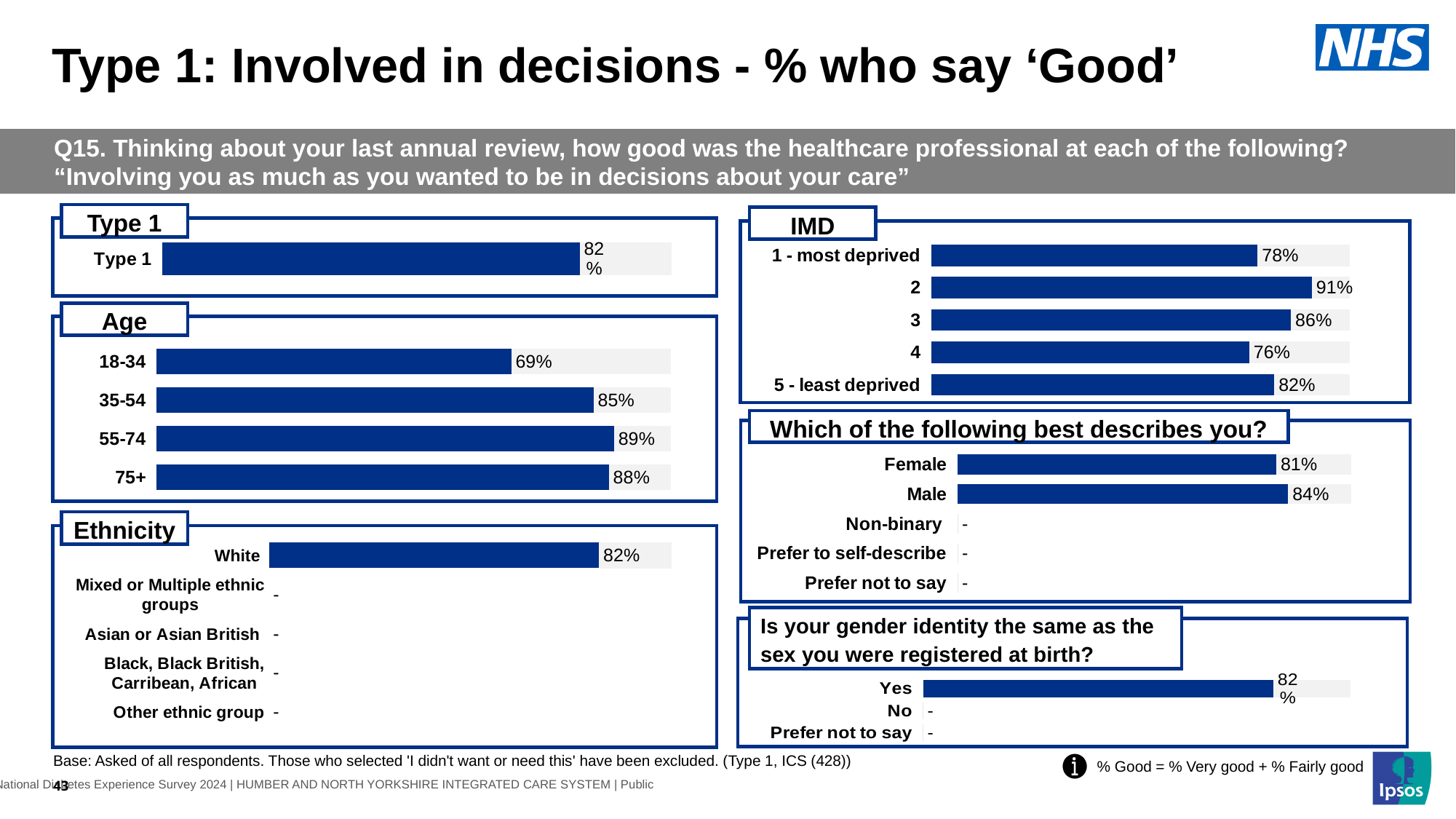
In the 'Which of the following best describes you?' chart, which is larger, Female or Male? Male In the Age chart, which age group has the highest value? 55-74 In the Age chart, what is the value for the 18-34 group? 69% In the Age chart, which age group has the lowest value? 18-34 In the Ethnicity chart, how many categories are listed? 5 In the Ethnicity chart, what is the value for White? 82% In the 'Is your gender identity the same as the sex you were registered at birth?' chart, what is the value for Yes? 82% In the IMD chart, which category has the lowest value? 4 What kind of chart is the IMD chart? Bar chart In the IMD chart, what is the difference between '1 - most deprived' and '5 - least deprived'? 4 percentage points In the IMD chart, what is the value for '2'? 91% In the 'Which of the following best describes you?' chart, what is the value for Female? 81%